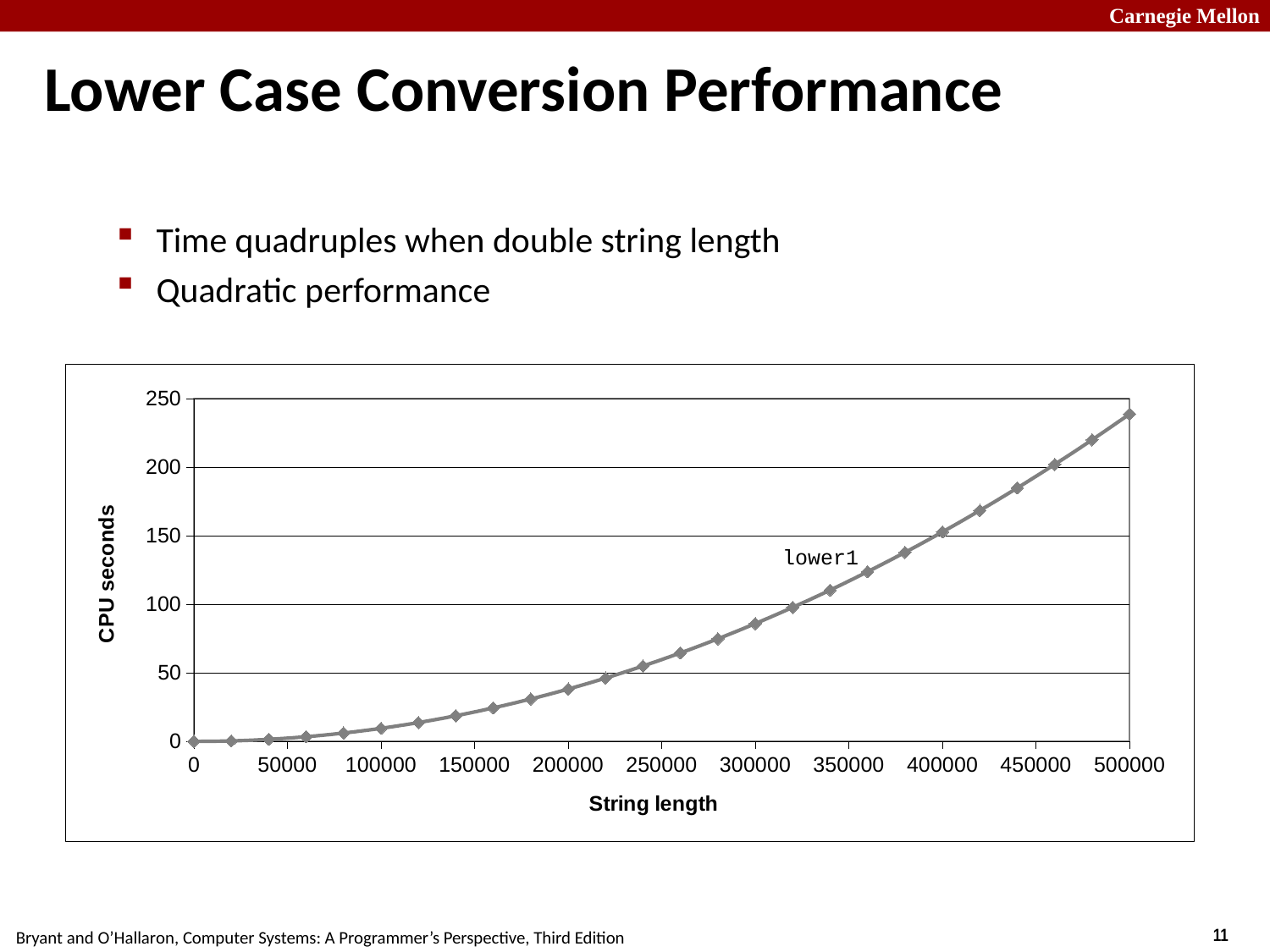
Is the CPU seconds value at string length 300000 greater or less than 100? less At which string length is the CPU seconds value lowest? 0 At which string length is the CPU seconds value highest? 500000 What is the label of the plotted series in the chart? lower1 Is the CPU seconds value at string length 400000 greater or less than 100? greater What is the title of the y axis of the chart? CPU seconds Do the CPU seconds values rise or fall as string length increases along the x axis? rise Which has the larger CPU seconds value: string length 100000 or string length 400000? 400000 Is the CPU seconds value at string length 200000 greater or less than 50? less What kind of chart is shown on the slide? line chart How many series does the chart plot? 1